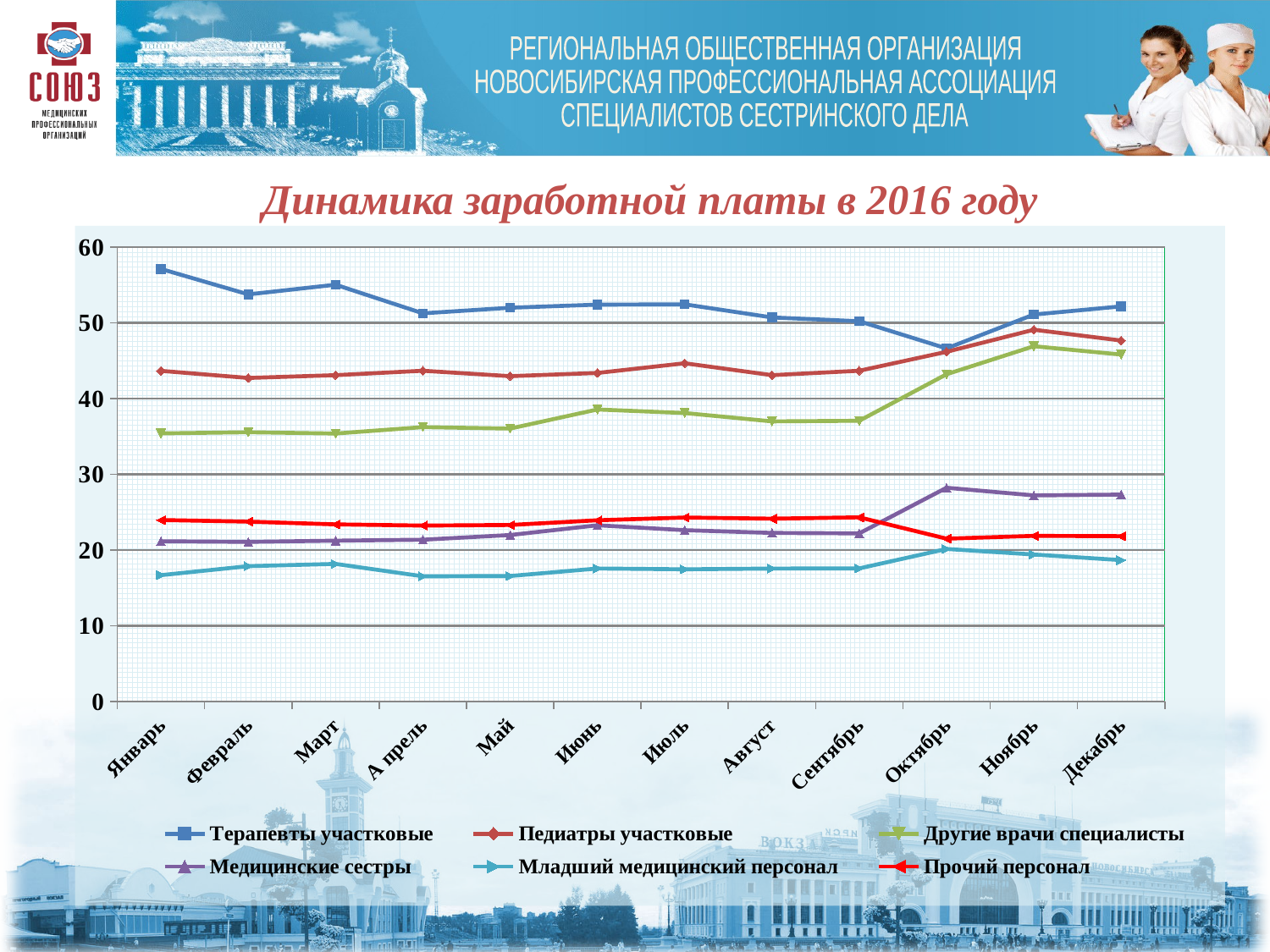
Is the value for Другие врачи специалисты in Январь greater or less than 40? less What is the title of the chart? Динамика заработной платы в 2016 году Which series has the highest value in Январь? Терапевты участковые Which series has the lowest value in Январь? Младший медицинский персонал How many months are shown along the x axis? 12 Is the value for Медицинские сестры in Октябрь greater or less than 30? less Does the value for Другие врачи специалисты rise or fall from Сентябрь to Ноябрь? rise How many series does the legend list? 6 In Декабрь, which is larger: Медицинские сестры or Прочий персонал? Медицинские сестры Is the value for Младший медицинский персонал in Январь greater or less than 20? less What kind of chart is shown on the slide? Line chart